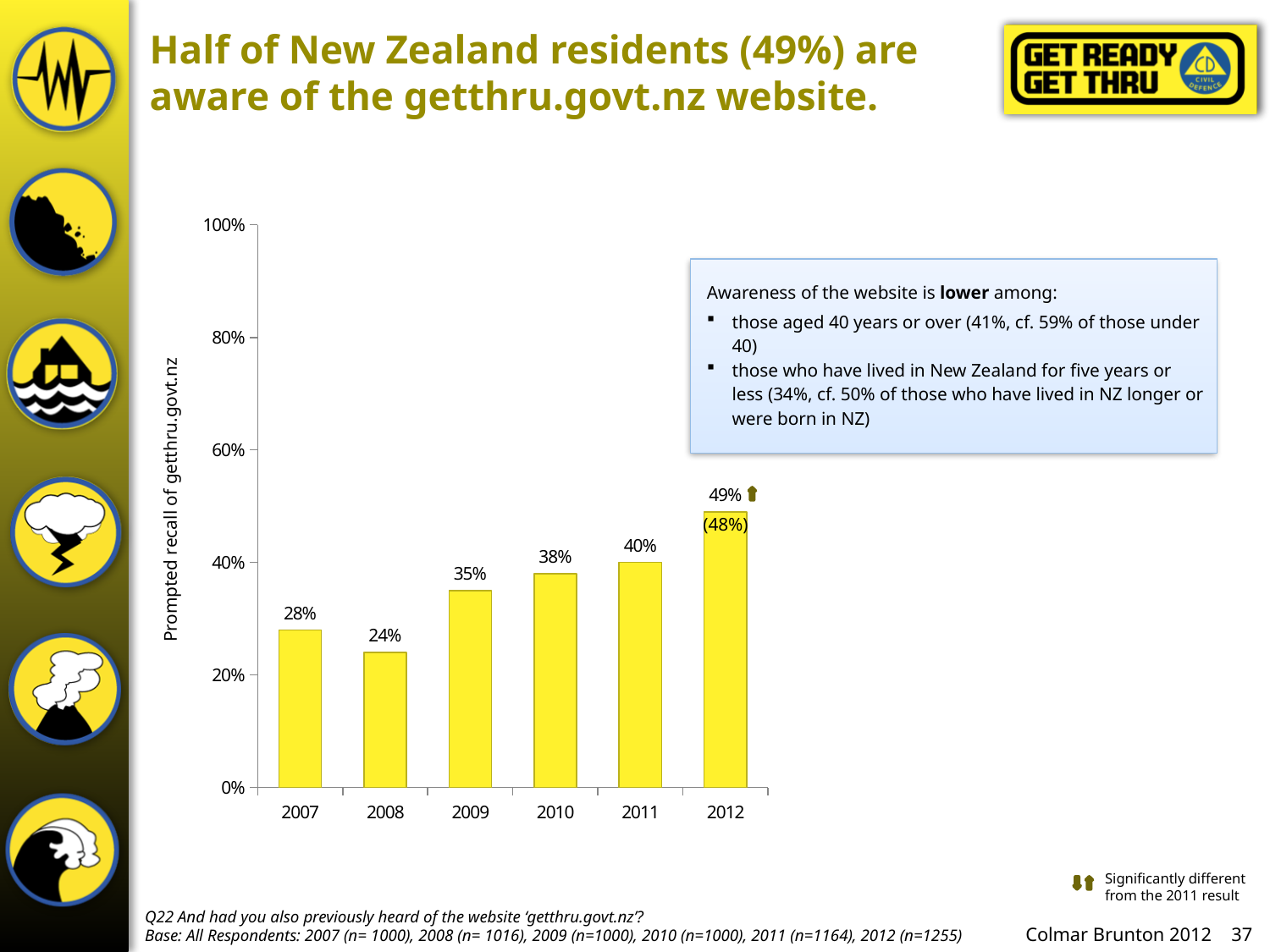
How many years are shown on the x axis of the chart? 6 What is the label on the vertical axis of the chart? Prompted recall of getthru.govt.nz Which year has the lowest prompted recall of getthru.govt.nz? 2008 Which year has a higher value, 2007 or 2009? 2009 What is the difference between the 2009 value and the 2008 value? 11% What is the difference between the 2012 value and the 2011 value? 9% What is the prompted recall of getthru.govt.nz in 2007? 28% What kind of chart is shown on the slide? bar chart What is the value shown for 2010? 38% Is the value for 2011 greater or less than 60%? less Which year has the highest prompted recall of getthru.govt.nz? 2012 What is the prompted recall of getthru.govt.nz in 2012? 49%